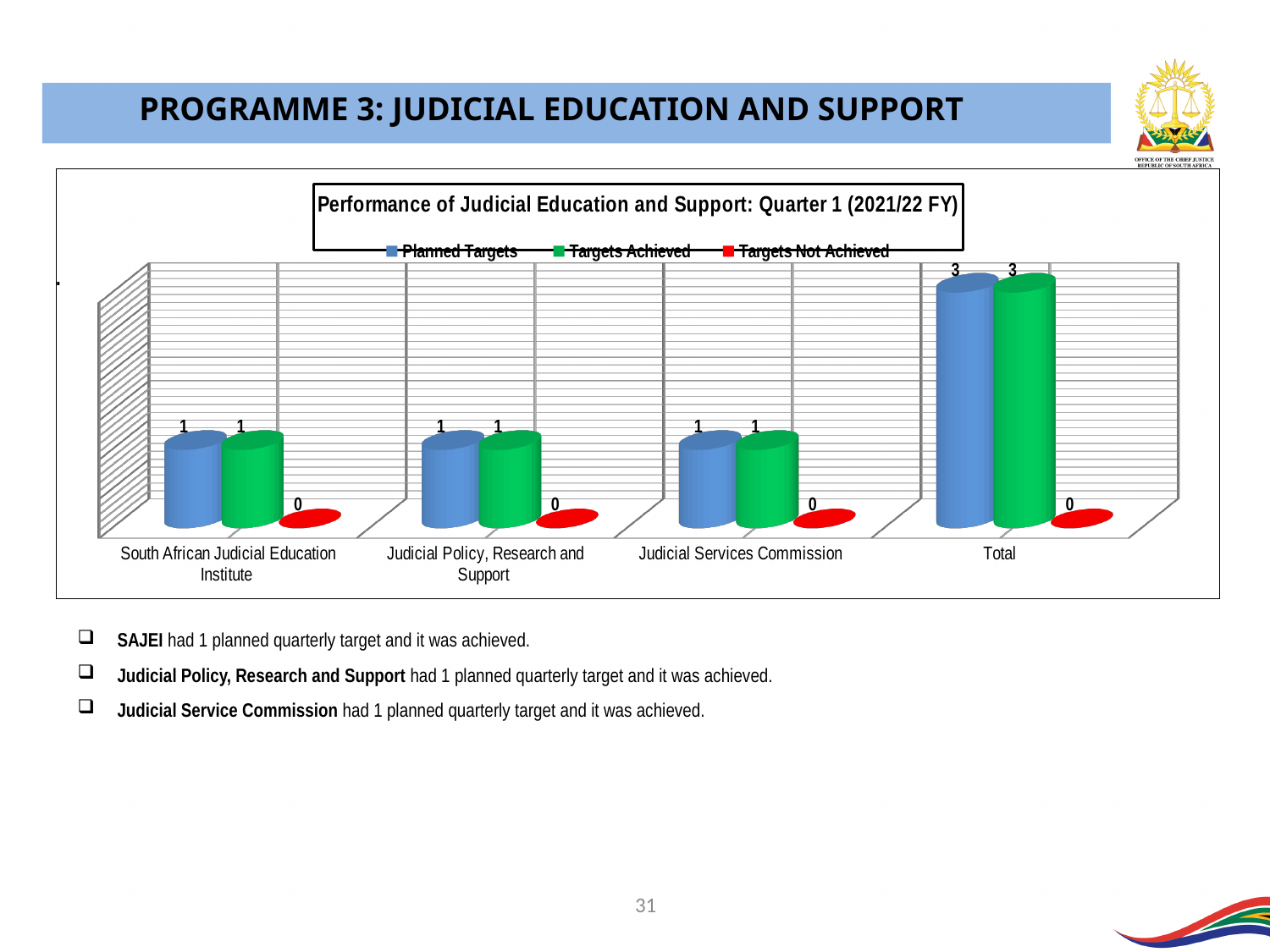
What is the Targets Not Achieved value for South African Judicial Education Institute? 0 What is the difference between Planned Targets and Targets Achieved for Judicial Services Commission? 0 What is the title of the chart? Performance of Judicial Education and Support: Quarter 1 (2021/22 FY) What type of chart is shown on the slide? bar chart How many series does the legend list? 3 What is the Planned Targets value for Total? 3 Which is larger: Targets Achieved for Total or Targets Achieved for South African Judicial Education Institute? Total What is the Targets Achieved value for Judicial Services Commission? 1 How many categories are shown on the x axis? 4 Which series is shown in red? Targets Not Achieved Which category has the highest Planned Targets value? Total What is the difference between Planned Targets for Total and Planned Targets for Judicial Policy, Research and Support? 2